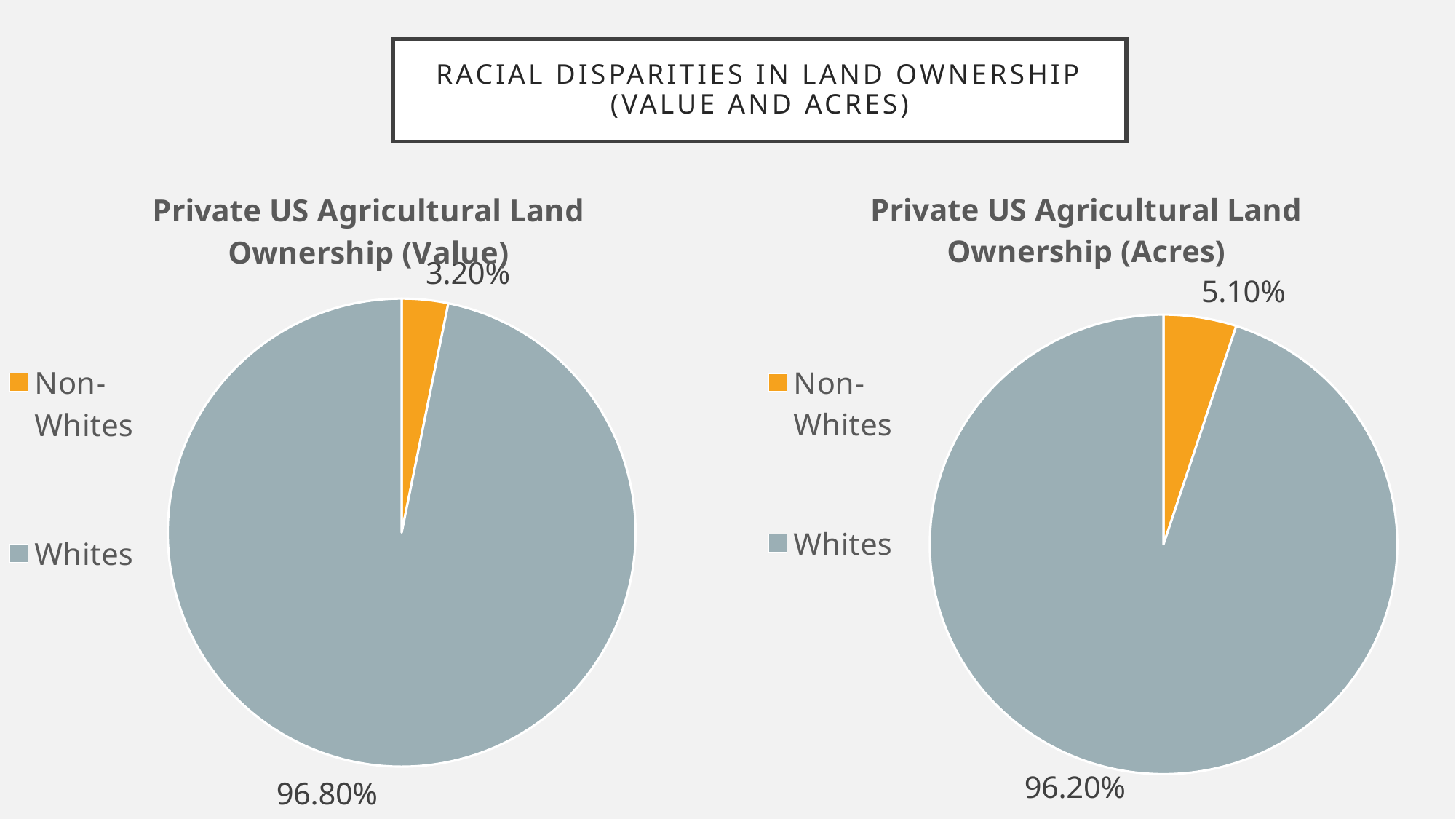
In the 'Private US Agricultural Land Ownership (Value)' chart, what share of the pie is Whites? 96.80% How many categories does the 'Private US Agricultural Land Ownership (Value)' chart show? 2 Is the Non-Whites share larger in the 'Private US Agricultural Land Ownership (Value)' chart or the 'Private US Agricultural Land Ownership (Acres)' chart? Acres In the 'Private US Agricultural Land Ownership (Value)' chart, what is the difference between the Whites and Non-Whites shares? 93.60% In the 'Private US Agricultural Land Ownership (Acres)' chart, what share of the pie is Whites? 96.20% In the 'Private US Agricultural Land Ownership (Value)' chart, what share of the pie is Non-Whites? 3.20% What kind of chart is the 'Private US Agricultural Land Ownership (Acres)' chart? Pie chart In the 'Private US Agricultural Land Ownership (Value)' chart, what colour is the Non-Whites slice? Orange In the 'Private US Agricultural Land Ownership (Value)' chart, which category has the largest slice? Whites In the 'Private US Agricultural Land Ownership (Acres)' chart, which category has the smallest slice? Non-Whites How many entries does the legend of the 'Private US Agricultural Land Ownership (Acres)' chart list? 2